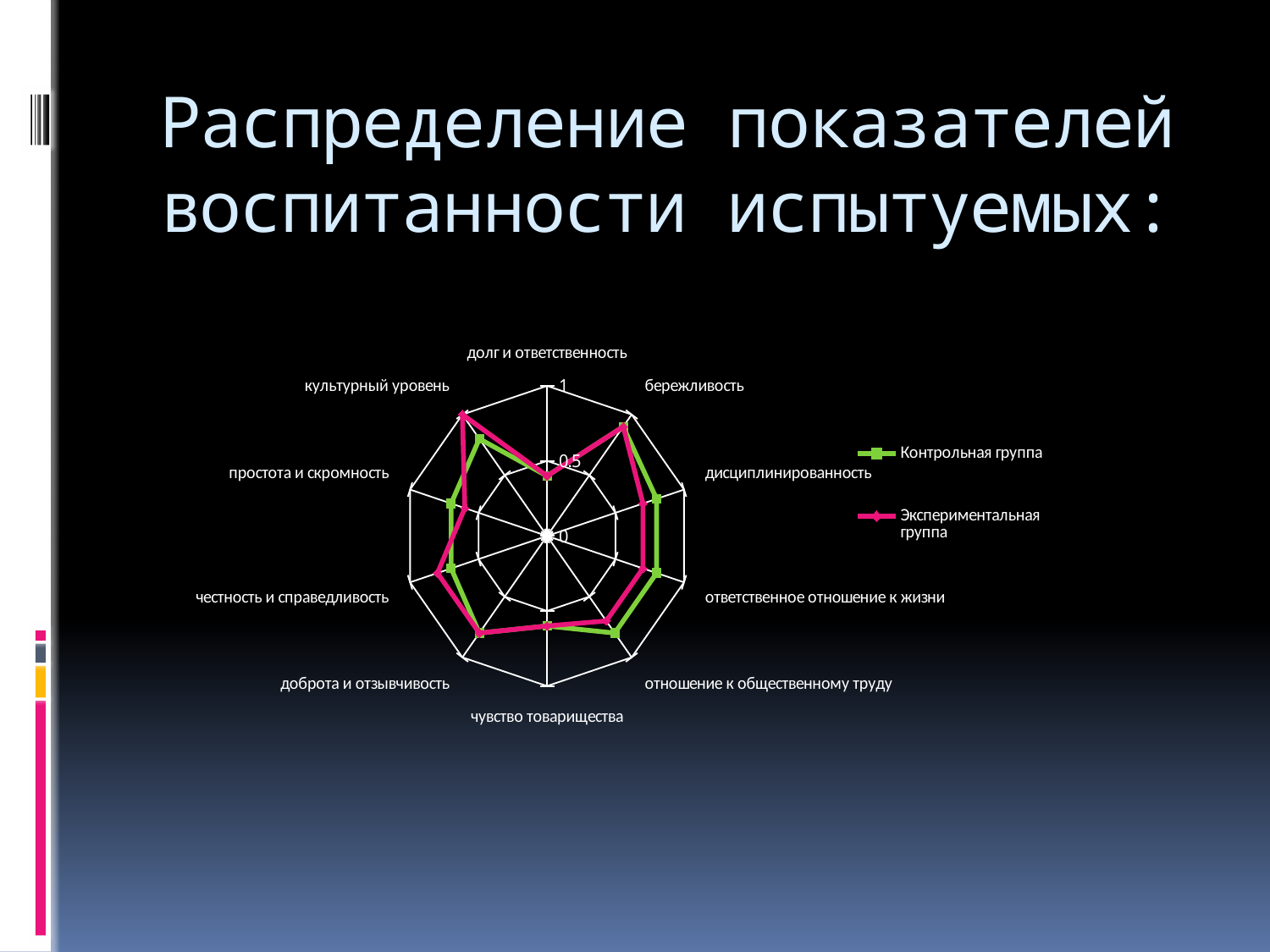
Which series is drawn in green? Контрольная группа Is the value for честность и справедливость for Экспериментальная группа greater or less than 0.5? greater For отношение к общественному труду, which series has the larger value, Контрольная группа or Экспериментальная группа? Контрольная группа What kind of chart is shown on the slide? radar chart For ответственное отношение к жизни, which series has the larger value, Контрольная группа or Экспериментальная группа? Контрольная группа Is the value for бережливость for Контрольная группа greater or less than 0.5? greater How many categories (axes) does the radar chart have? 10 Is the value for ответственное отношение к жизни for Контрольная группа greater or less than 0.5? greater How many series does the legend list? 2 Which series is drawn in pink? Экспериментальная группа For культурный уровень, which series has the larger value, Контрольная группа or Экспериментальная группа? Экспериментальная группа